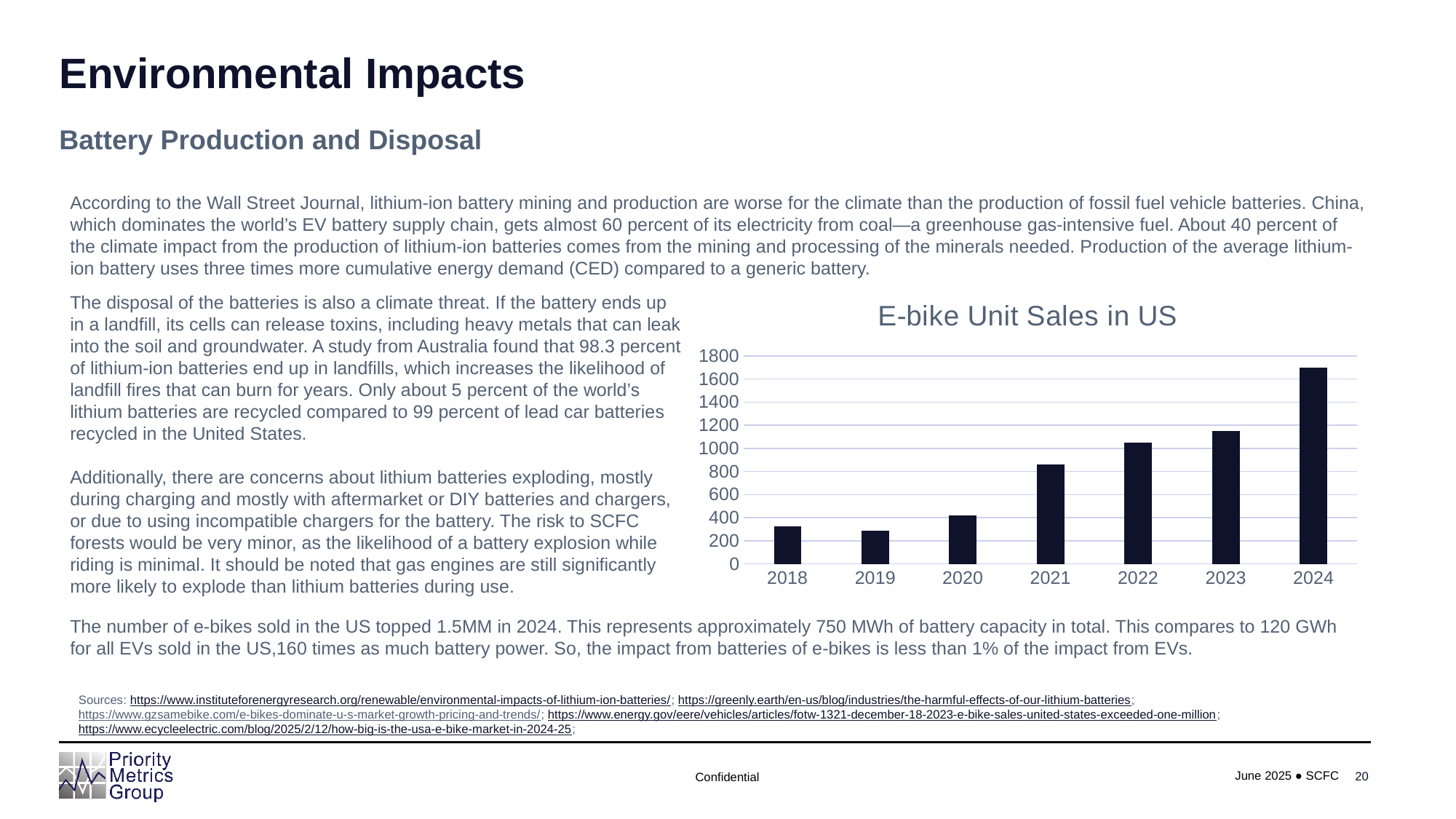
Is the value for 2023 greater or less than 1200? less Is the value for 2024 greater or less than 1600? greater What kind of chart is used to show E-bike Unit Sales in US? bar chart Is the value for 2021 greater or less than 800? greater How many years are shown on the x axis of the E-bike Unit Sales in US chart? 7 Do e-bike unit sales generally rise or fall from 2019 to 2024? rise Which year has higher e-bike unit sales, 2021 or 2022? 2022 Which year has the highest e-bike unit sales in the chart? 2024 Which year has the lowest e-bike unit sales in the chart? 2019 What is the title of the chart on the slide? E-bike Unit Sales in US